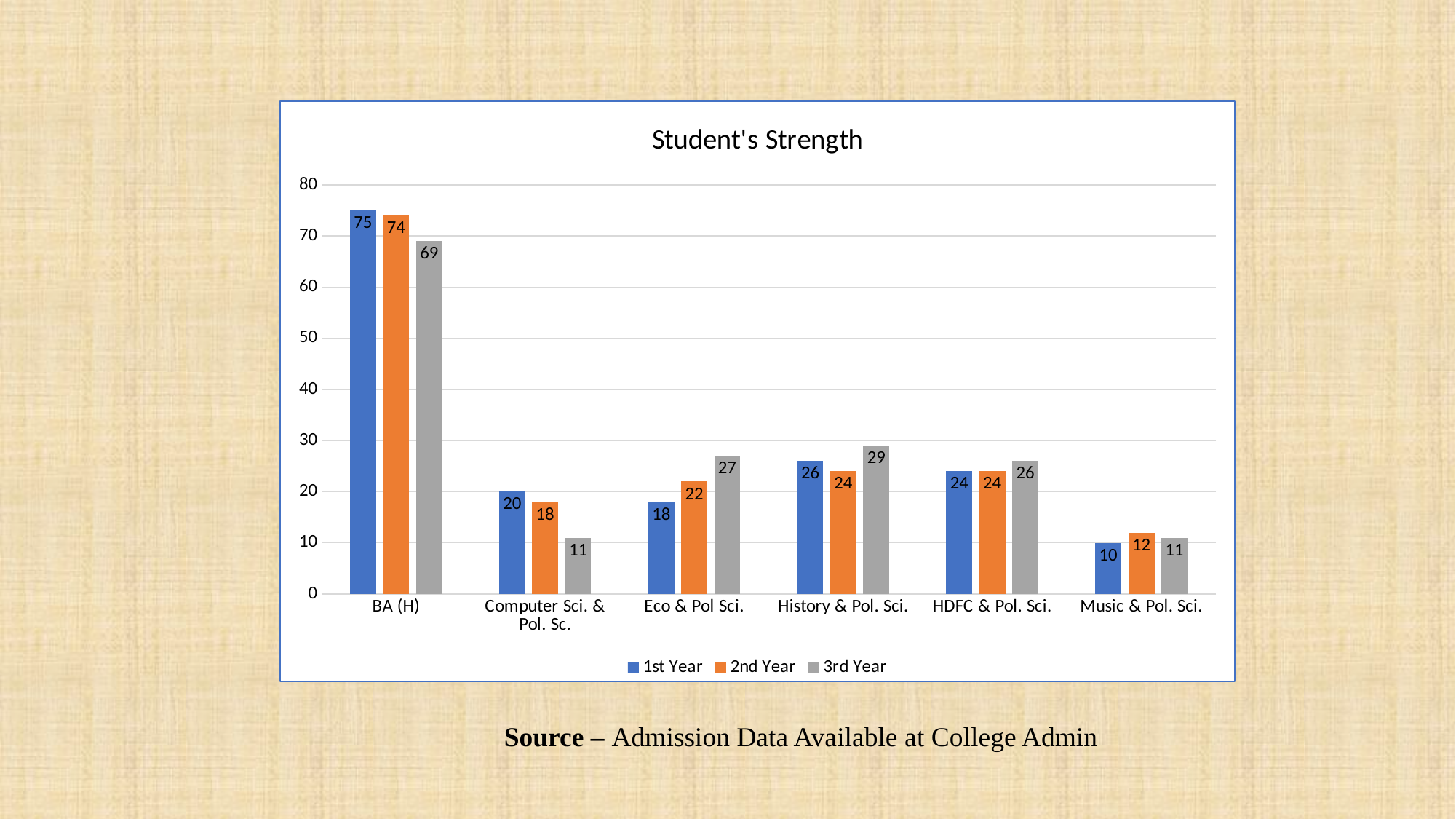
Which category has the highest 3rd Year value? BA (H) Which colour represents the 2nd Year series? Orange What is the title of the chart? Student's Strength What is the difference between the 1st Year and 3rd Year values for BA (H)? 6 How many categories are shown on the x axis? 6 What kind of chart is shown? Bar chart Which is larger for History & Pol. Sci.: the 1st Year value or the 3rd Year value? 3rd Year What is the 3rd Year value for Computer Sci. & Pol. Sc.? 11 How many series does the legend list? 3 What is the 2nd Year value for Eco & Pol Sci.? 22 What is the 1st Year value for BA (H)? 75 Which category has the lowest 1st Year value? Music & Pol. Sci.